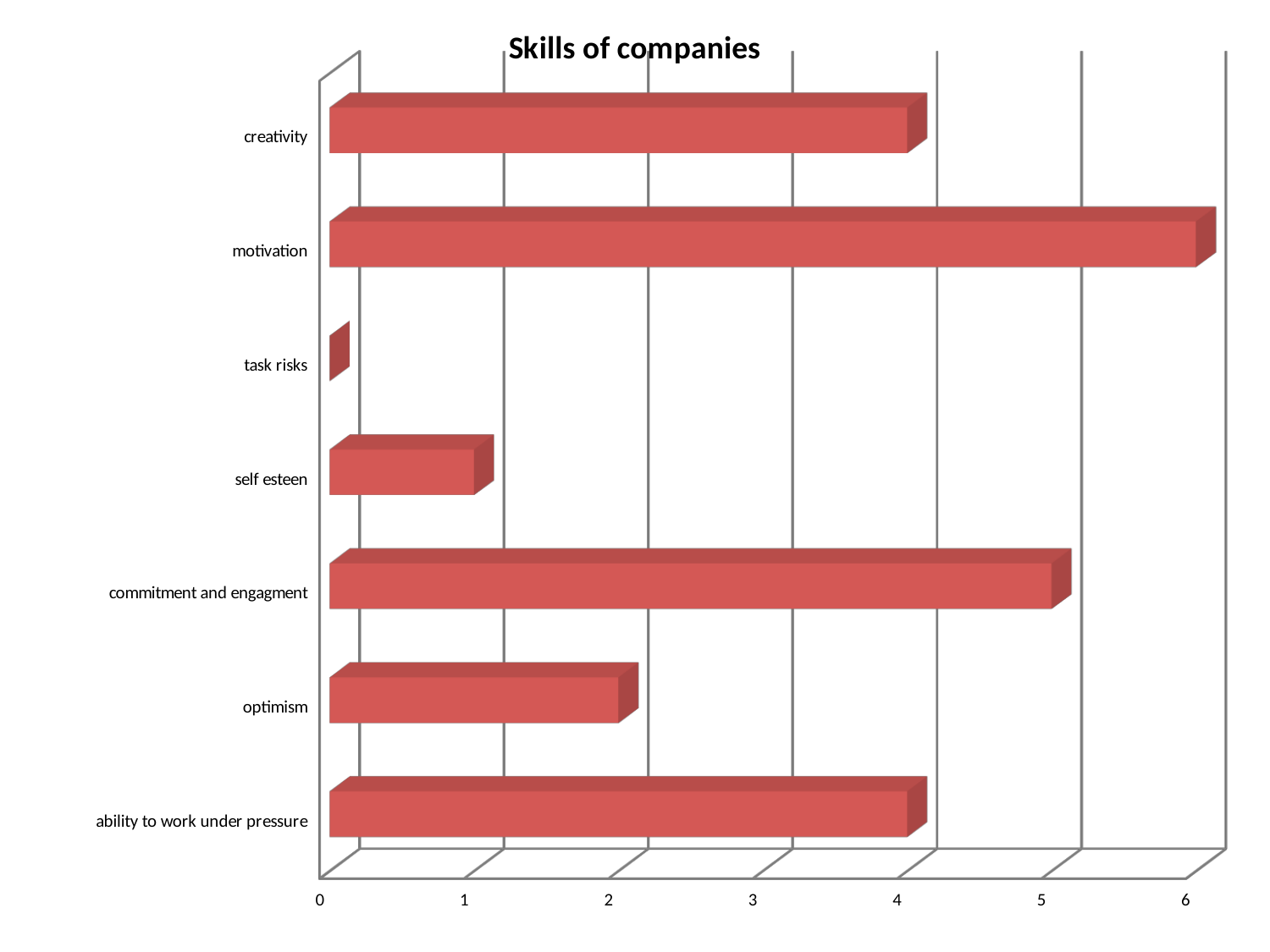
Which is larger, the value for commitment and engagment or the value for creativity? commitment and engagment How many skill categories are plotted in the chart? 7 Is the value for task risks greater or less than 1? less What is the value for commitment and engagment? 5 What is the value for optimism? 2 What type of chart is shown on the slide? bar chart What is the value for self esteen? 1 What is the value for motivation? 6 What is the difference between the value for motivation and the value for self esteen? 5 Which skill has the lowest value? task risks Which skill has the highest value? motivation What is the title of the chart? Skills of companies